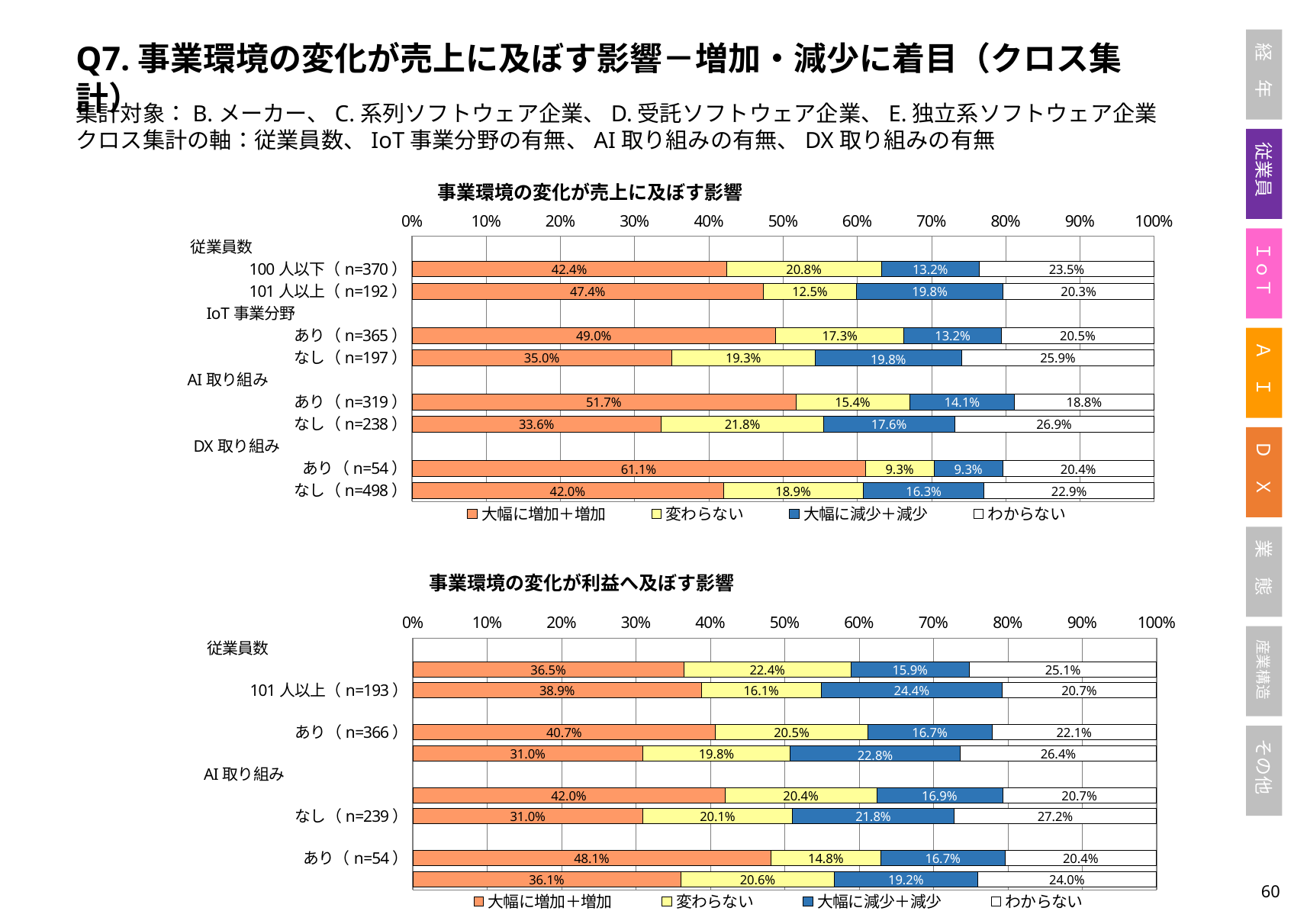
In the chart titled 事業環境の変化が利益へ及ぼす影響, what is the 大幅に減少＋減少 value for 101人以上（n=193）? 24.4% In the chart titled 事業環境の変化が売上に及ぼす影響, what is the difference between the 大幅に増加＋増加 values for IoT事業分野 あり（n=365） and なし（n=197）? 14.0% How many series does the legend of the chart titled 事業環境の変化が売上に及ぼす影響 list? 4 In the chart titled 事業環境の変化が売上に及ぼす影響, which category has the highest 大幅に増加＋増加 value? DX取り組み あり（n=54） In the chart titled 事業環境の変化が売上に及ぼす影響, what is the わからない value for AI取り組み なし（n=238）? 26.9% In the chart titled 事業環境の変化が売上に及ぼす影響, which category has the lowest 大幅に増加＋増加 value? AI取り組み なし（n=238） In the chart titled 事業環境の変化が売上に及ぼす影響, which is larger: the 大幅に減少＋減少 value for 100人以下（n=370） or for 101人以上（n=192）? 101人以上（n=192） In the chart titled 事業環境の変化が利益へ及ぼす影響, what is the difference between the わからない values for なし（n=239） and あり（n=366）? 5.1% In the chart titled 事業環境の変化が売上に及ぼす影響, what is the 大幅に増加＋増加 value for DX取り組み あり（n=54）? 61.1% What kind of chart is the chart titled 事業環境の変化が利益へ及ぼす影響? Stacked bar chart In the chart titled 事業環境の変化が利益へ及ぼす影響, what is the 大幅に増加＋増加 value for あり（n=54）? 48.1% In the chart titled 事業環境の変化が売上に及ぼす影響, how many category bars are plotted? 8